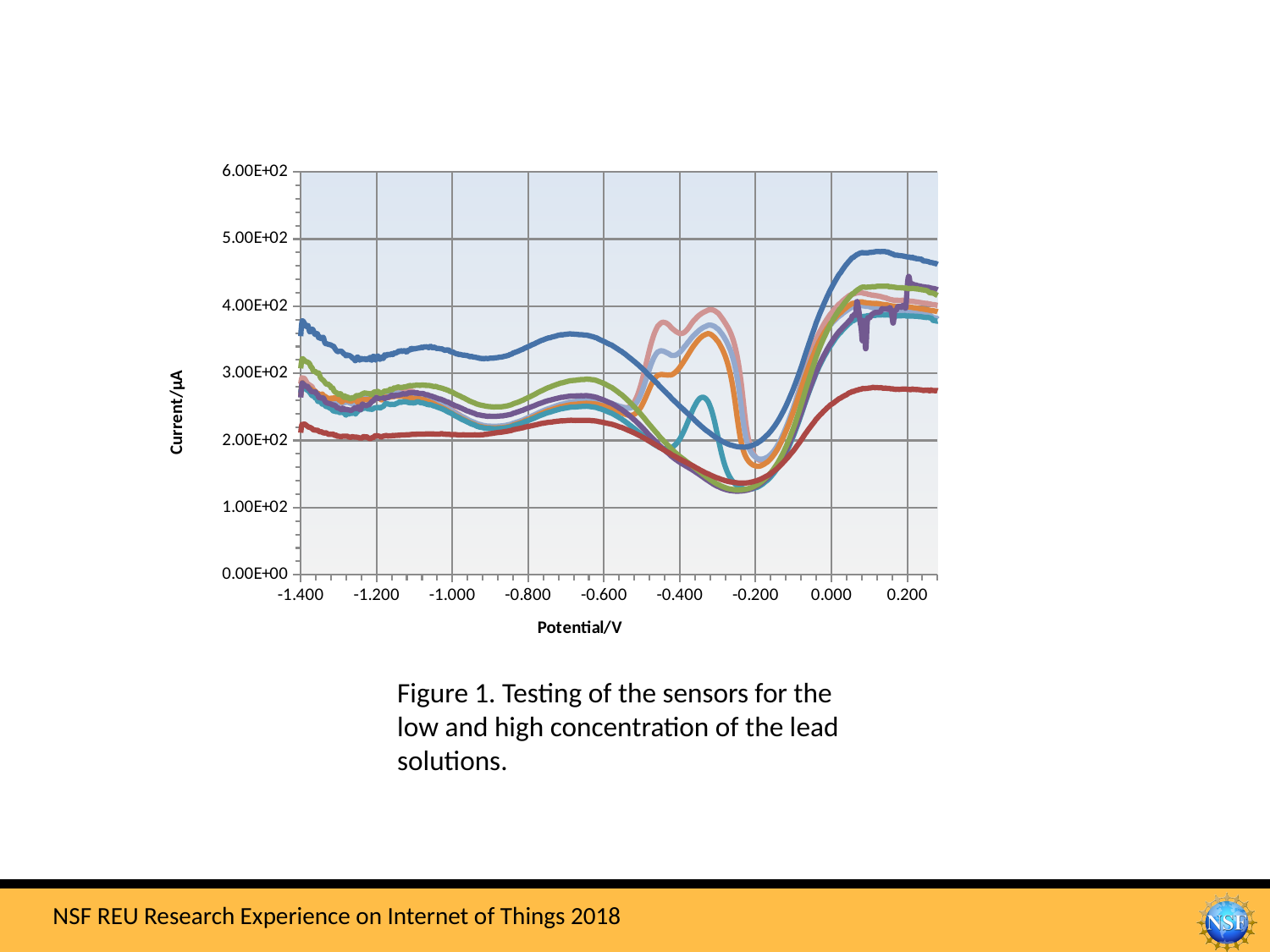
What is the label of the y axis of the chart? Current/µA Do the lines on the chart generally rise or fall between a potential of -1.400 V and -1.200 V? fall Is the highest current reached by any line on the chart greater or less than 5.00E+02? less What kind of chart is shown on the slide? line chart Do the lines on the chart generally rise or fall between a potential of -0.200 V and 0.000 V? rise Is the lowest current reached by any line on the chart greater or less than 1.00E+02? greater What is the label of the x axis of the chart? Potential/V